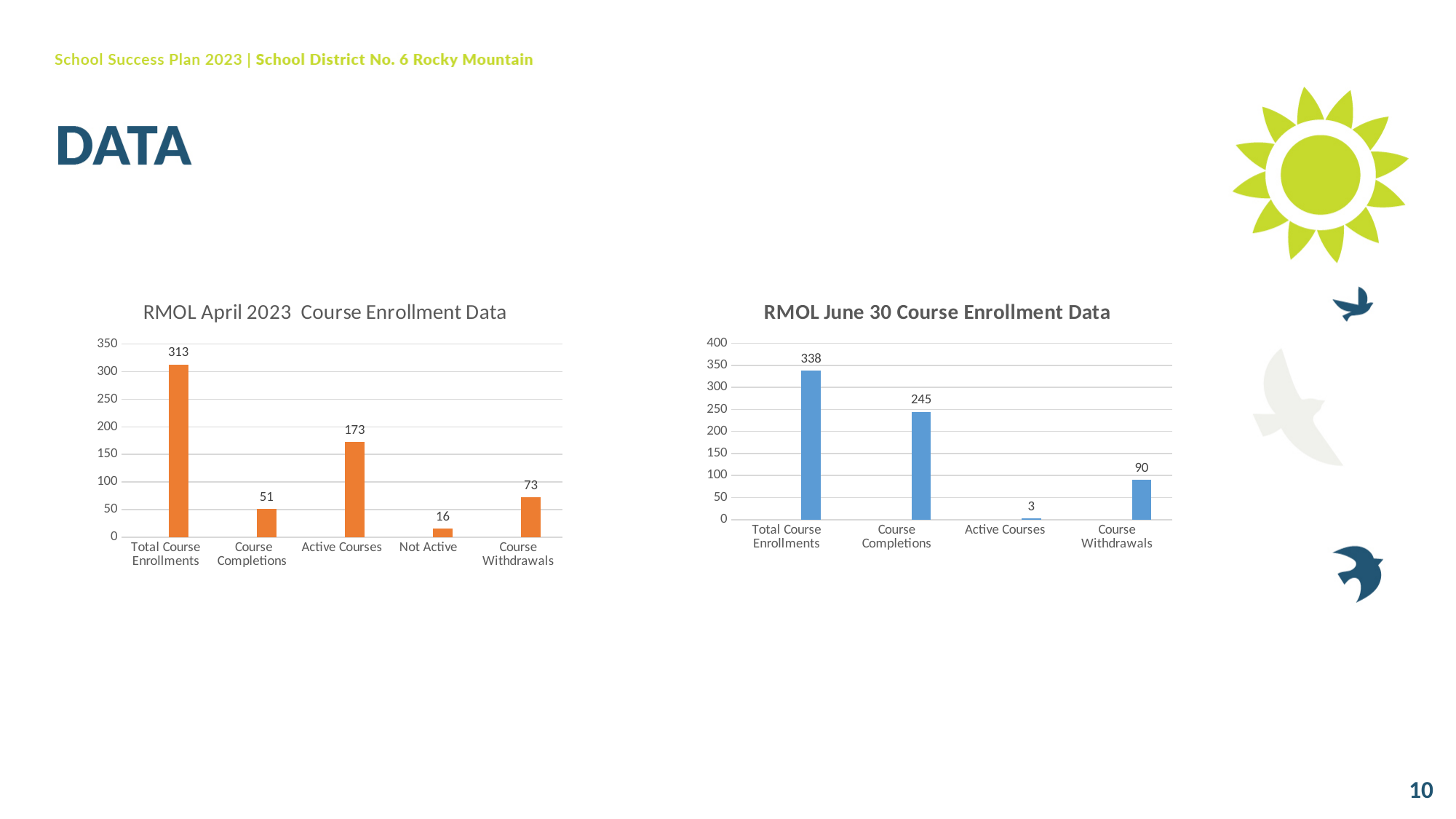
What type of chart is the RMOL June 30 Course Enrollment Data chart? Bar chart How many categories are shown in the RMOL April 2023 Course Enrollment Data chart? 5 In the RMOL June 30 Course Enrollment Data chart, what is the value for Active Courses? 3 In the RMOL June 30 Course Enrollment Data chart, what is the value for Course Completions? 245 In the RMOL June 30 Course Enrollment Data chart, which category has the highest value? Total Course Enrollments In the RMOL April 2023 Course Enrollment Data chart, which is larger: Course Withdrawals or Course Completions? Course Withdrawals In the RMOL June 30 Course Enrollment Data chart, what is the difference between Total Course Enrollments and Course Withdrawals? 248 In the RMOL April 2023 Course Enrollment Data chart, what is the value for Total Course Enrollments? 313 In the RMOL April 2023 Course Enrollment Data chart, what is the value for Not Active? 16 How many categories are shown in the RMOL June 30 Course Enrollment Data chart? 4 In the RMOL April 2023 Course Enrollment Data chart, what is the difference between Active Courses and Course Completions? 122 In the RMOL April 2023 Course Enrollment Data chart, which category has the lowest value? Not Active